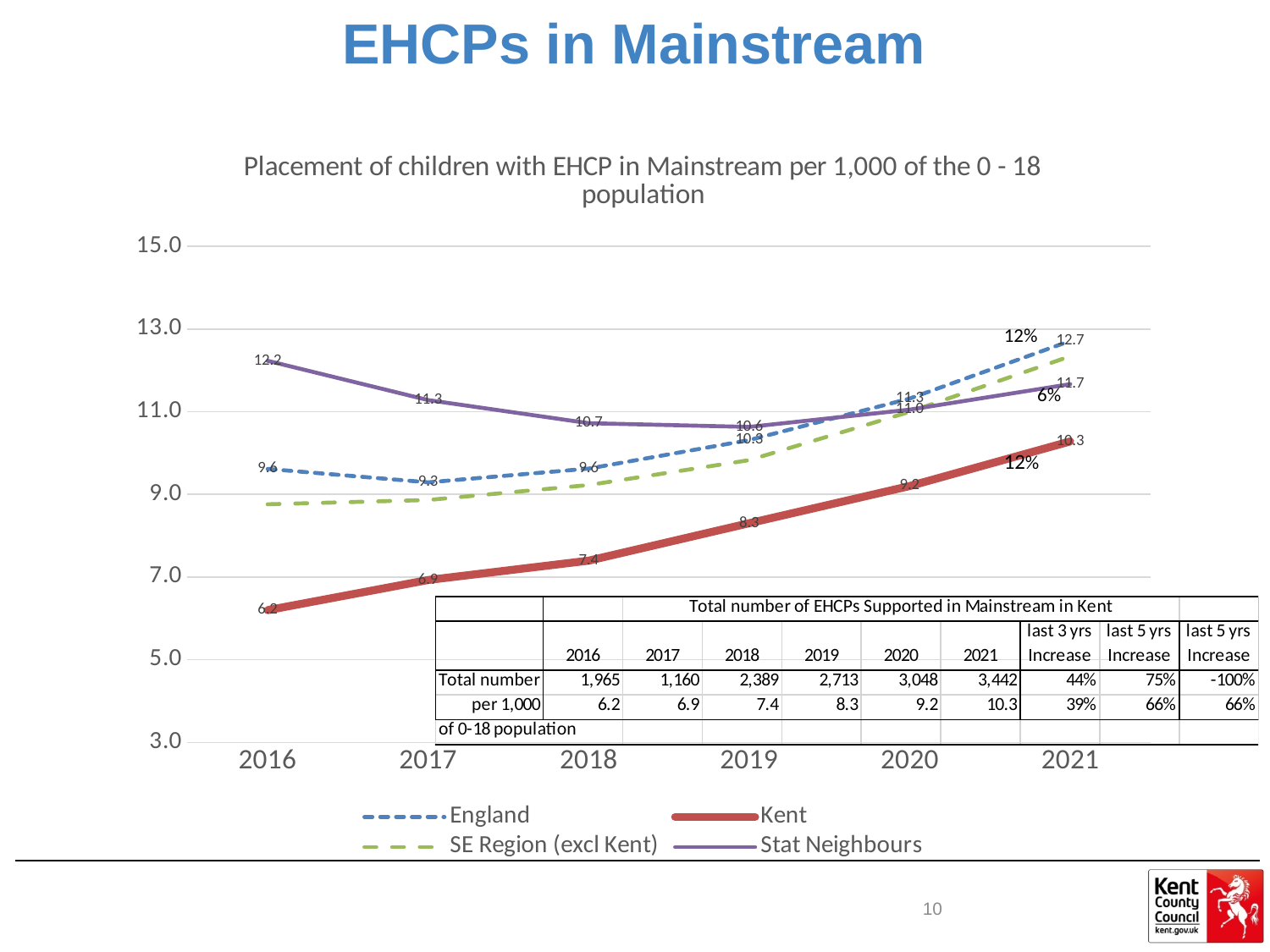
Is the value for SE Region (excl Kent) in 2021 greater or less than 11.0? greater How many series does the chart legend list? 4 How many years are plotted along the x axis of the chart? 6 What is the value for Kent in 2021? 10.3 Does the Kent line rise or fall from 2016 to 2021? rises What is the value for England in 2021? 12.7 In which year is the Stat Neighbours value lowest? 2019 What is the value for Kent in 2016? 6.2 In 2021, which is larger: the value for England or the value for Kent? England What is the difference between the Kent value in 2021 and the Kent value in 2016? 4.1 What is the value for Stat Neighbours in 2016? 12.2 What type of chart is shown on the slide? line chart